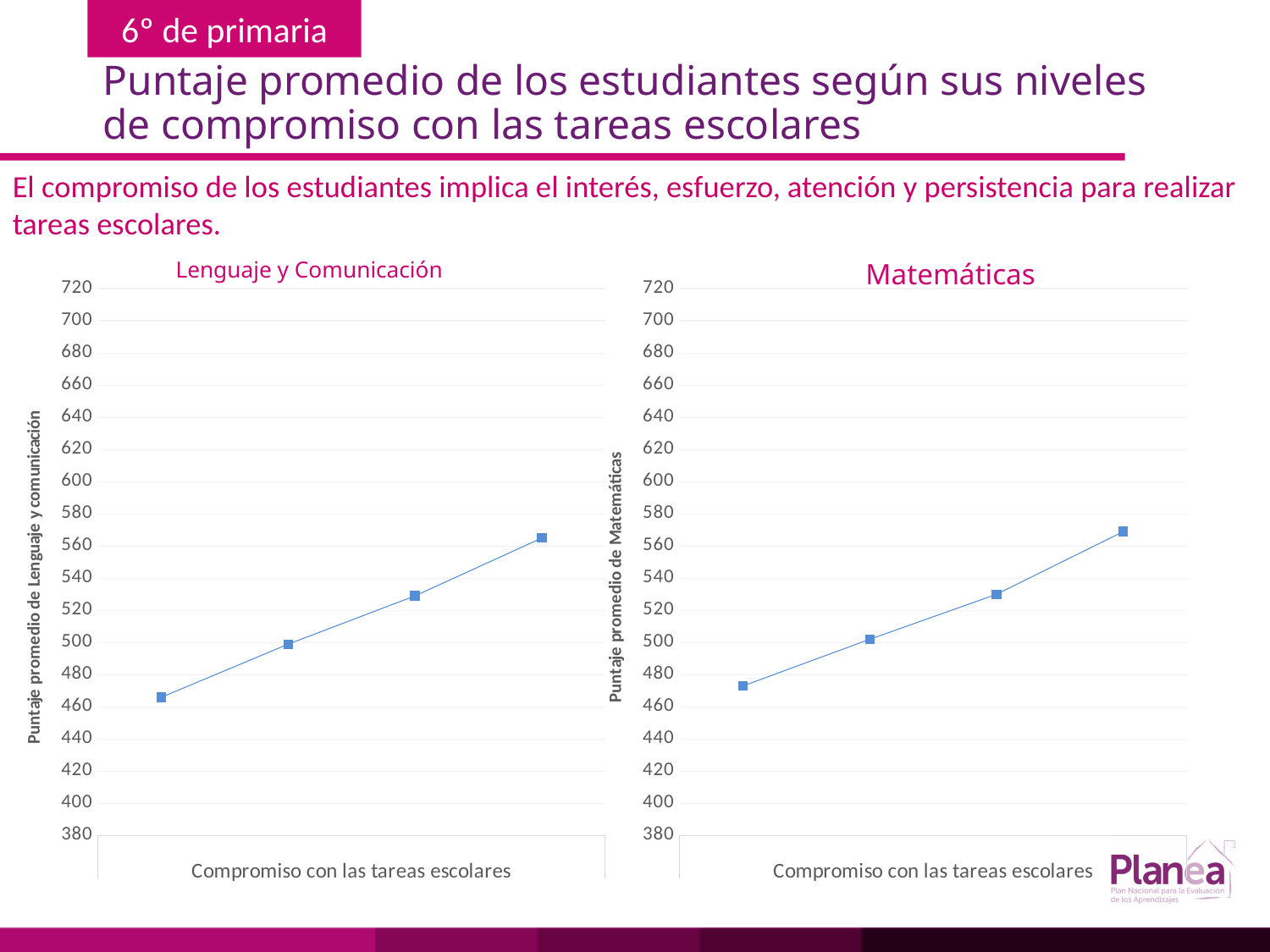
On the Matemáticas chart, is the value of the leftmost point greater or less than 480? less What is the y-axis label on the Lenguaje y Comunicación chart? Puntaje promedio de Lenguaje y comunicación How many data points are plotted on the Lenguaje y Comunicación chart? 4 On the Matemáticas chart, do the values rise or fall from left to right along the x axis? rise What kind of chart is the Matemáticas chart? line chart On the Matemáticas chart, is the value of the rightmost point greater or less than 560? greater What kind of chart is the Lenguaje y Comunicación chart? line chart On the Lenguaje y Comunicación chart, is the value of the rightmost point greater or less than 560? greater On the Lenguaje y Comunicación chart, do the values rise or fall from left to right along the x axis? rise What is the x-axis label on the Matemáticas chart? Compromiso con las tareas escolares How many data points are plotted on the Matemáticas chart? 4